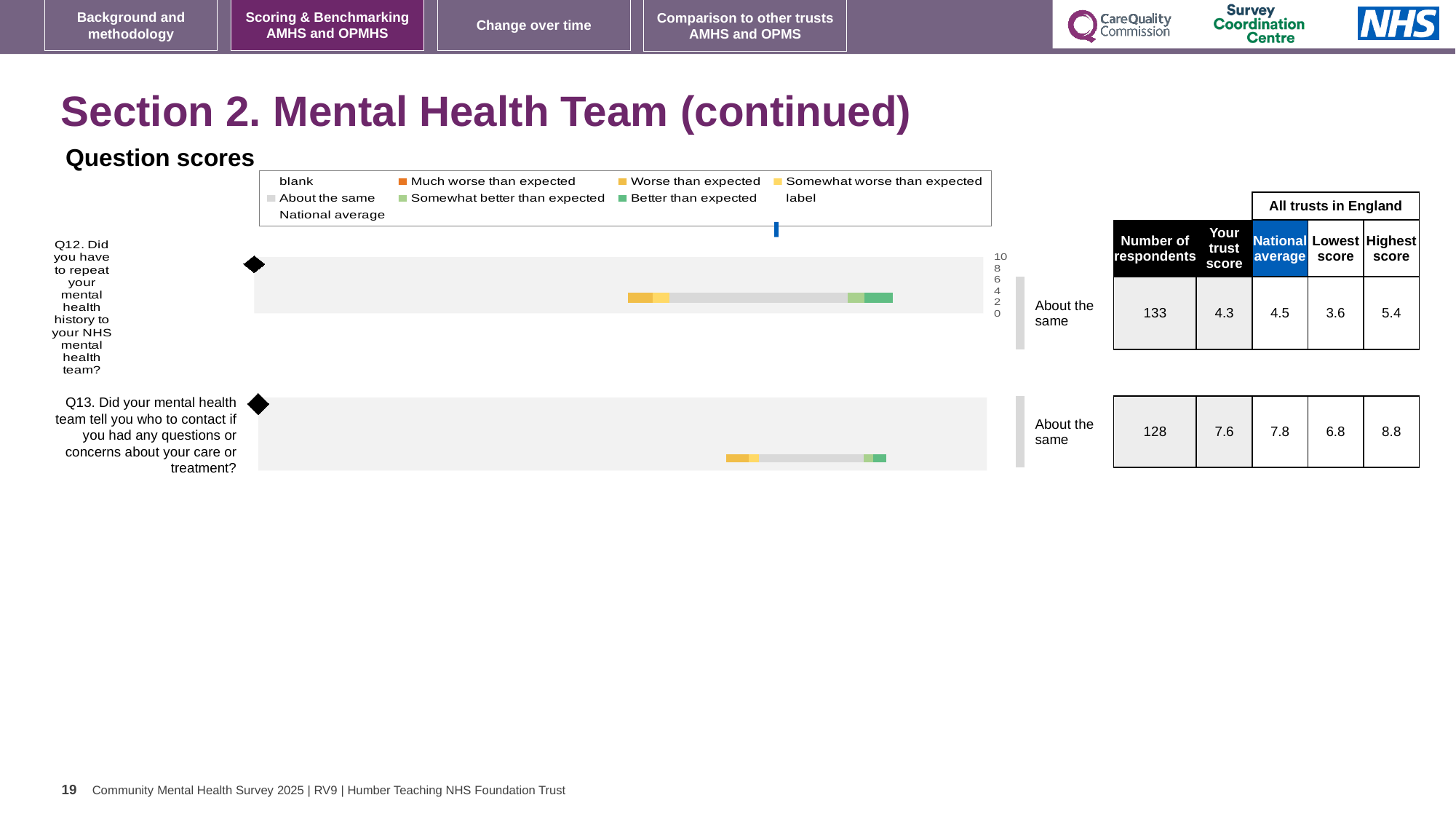
What benchmark category is shown for Q12? About the same How many respondents answered Q12? 133 How many questions are plotted in the question scores chart? 2 For Q13, which is larger: the trust score or the national average? National average What is the difference between the highest score and the lowest score for Q12? 1.8 What is the national average for Q13 (told who to contact with questions or concerns)? 7.8 How many entries does the legend of the question scores chart list? 9 Which question has the higher trust score, Q12 or Q13? Q13 What is the trust score for Q12 (repeating mental health history)? 4.3 What kind of chart is used to show the question scores on this slide? bar chart What is the highest score among all trusts in England for Q13? 8.8 Is the trust score for Q12 greater or less than 6 on the chart axis? less